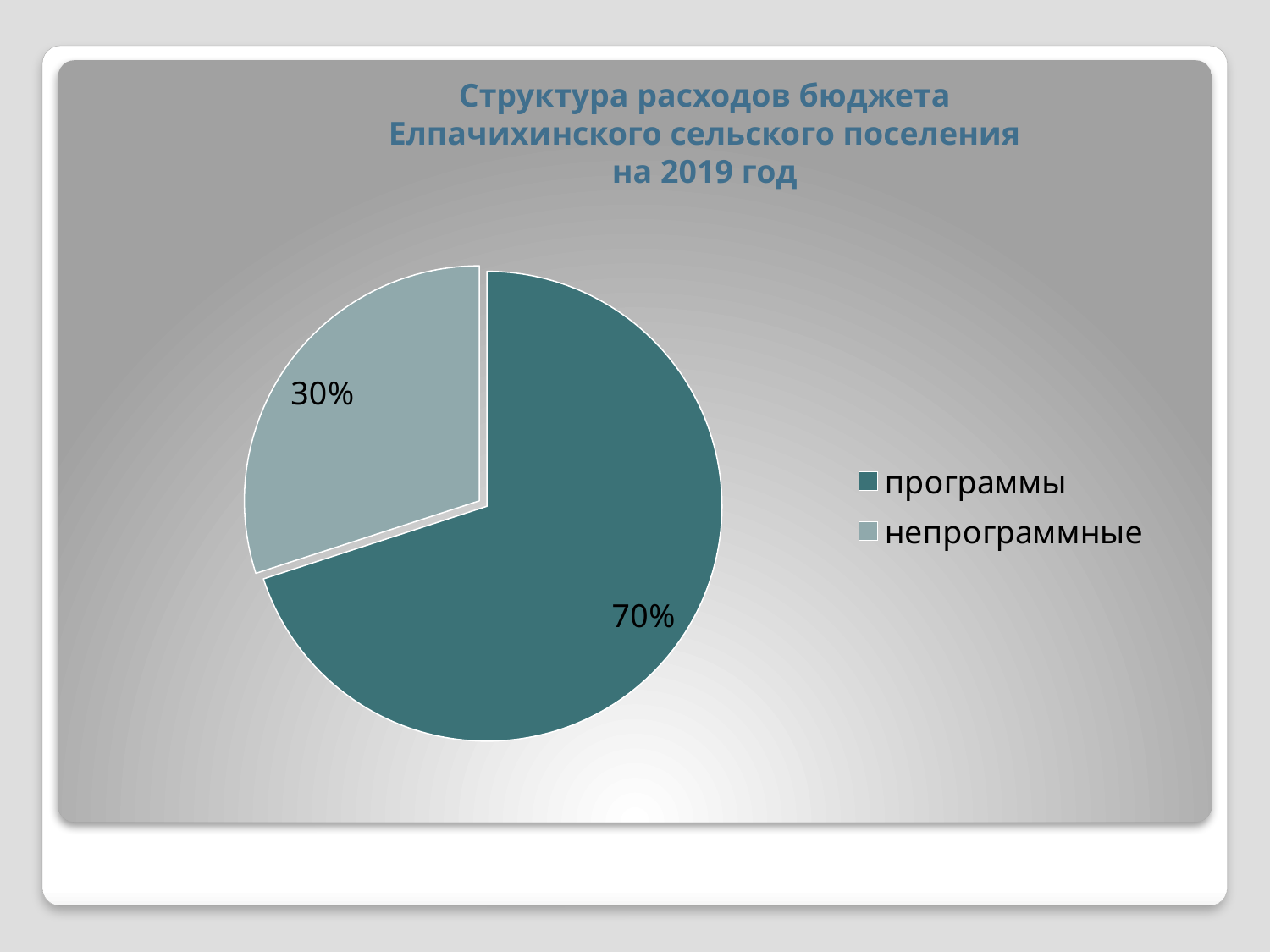
What share of the pie does the "программы" slice represent? 70% How many categories are shown in the pie chart? 2 What type of chart is shown on the slide? pie chart What share of the pie does the "непрограммные" slice represent? 30% What is the difference in percentage points between the "программы" and "непрограммные" slices? 40% Which is larger: the "программы" slice or the "непрограммные" slice? программы How many entries does the legend list? 2 Which category has the largest slice of the pie? программы Which category has the smallest slice of the pie? непрограммные What is the title of the chart? Структура расходов бюджета Елпачихинского сельского поселения на 2019 год Which slice is pulled out (exploded) from the pie? непрограммные